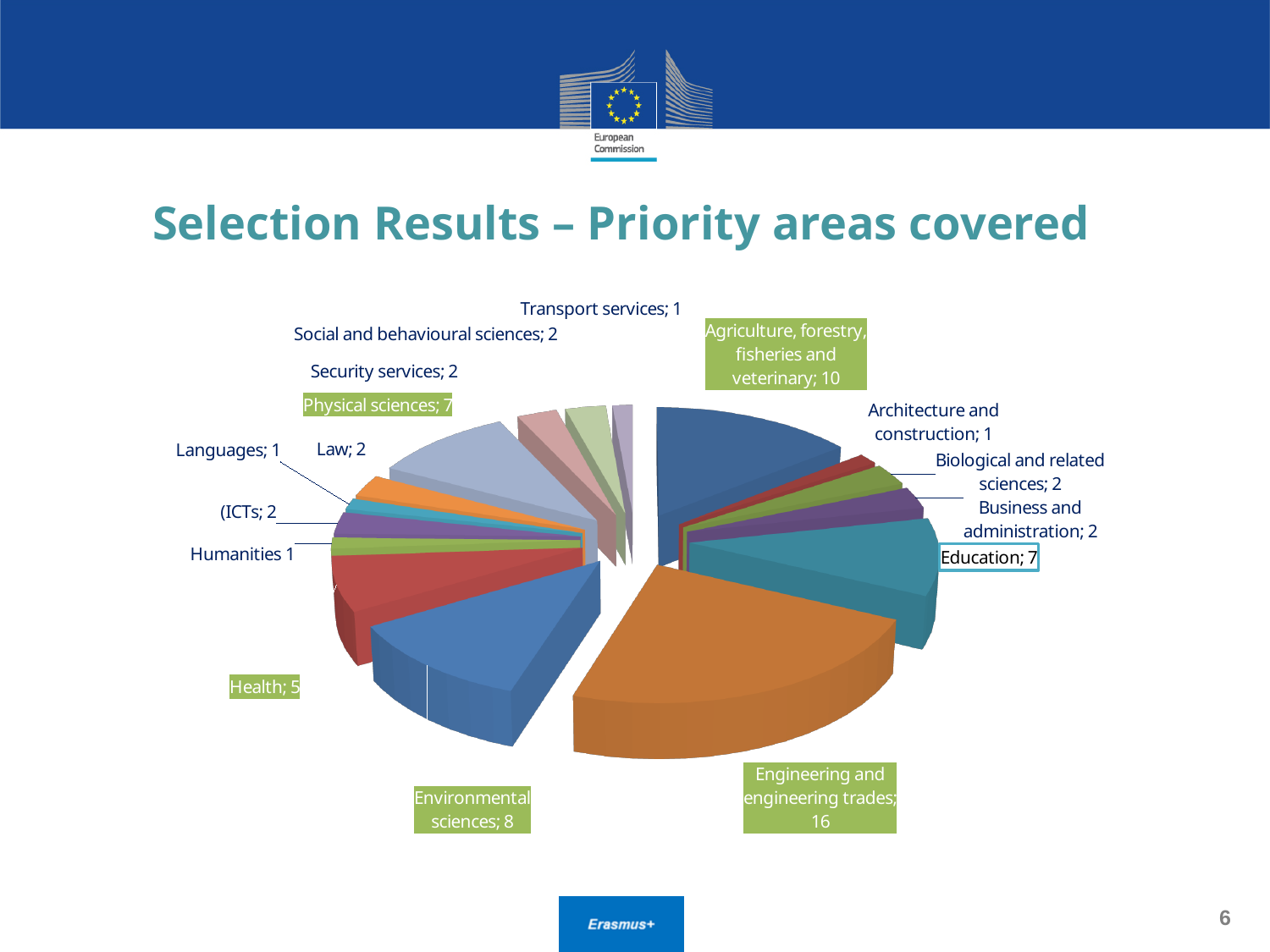
Which priority area has the largest slice of the pie? Engineering and engineering trades What is the smallest value shown on the pie chart? 1 What is the title of the slide containing the chart? Selection Results – Priority areas covered What is the value for Health? 5 What is the difference between the values for Engineering and engineering trades and Agriculture, forestry, fisheries and veterinary? 6 What is the value for Environmental sciences? 8 Which is larger, the value for Education or the value for Health? Education What is the value for Agriculture, forestry, fisheries and veterinary? 10 What is the value for Physical sciences? 7 How many priority areas are shown on the pie chart? 16 What type of chart is shown on the slide? pie chart What is the value for Engineering and engineering trades? 16